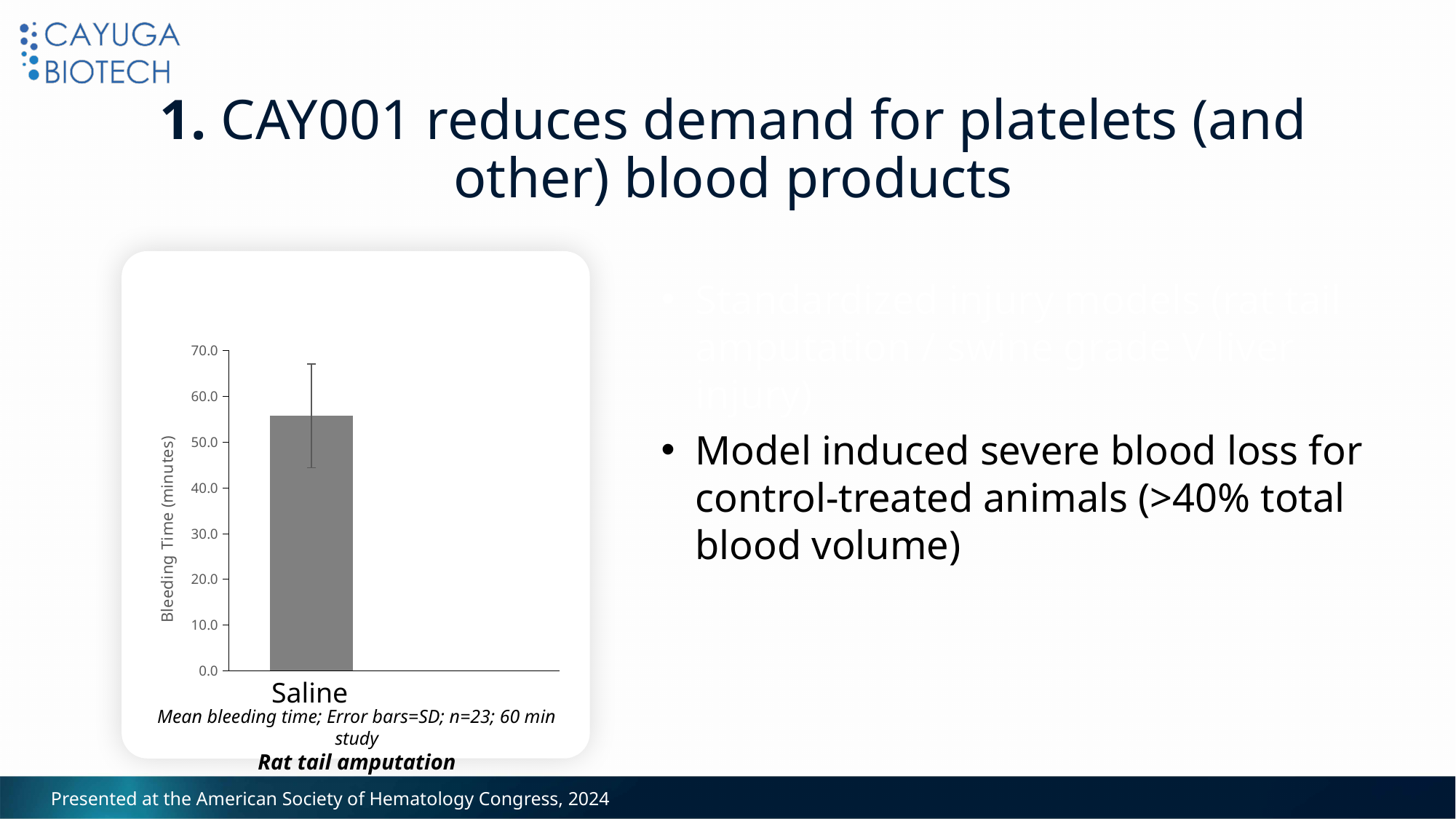
Is the value for Saline greater or less than 50.0? greater What kind of chart is shown on the slide? bar chart What is the y-axis label of the chart? Bleeding Time (minutes) Is the value for Saline greater or less than 40.0? greater What is the lowest tick value shown on the y axis of the chart? 0.0 What is the highest tick value shown on the y axis of the chart? 70.0 What is the label of the single category on the x axis of the chart? Saline Is the value for Saline greater or less than 60.0? less How many bars are plotted in the chart? 1